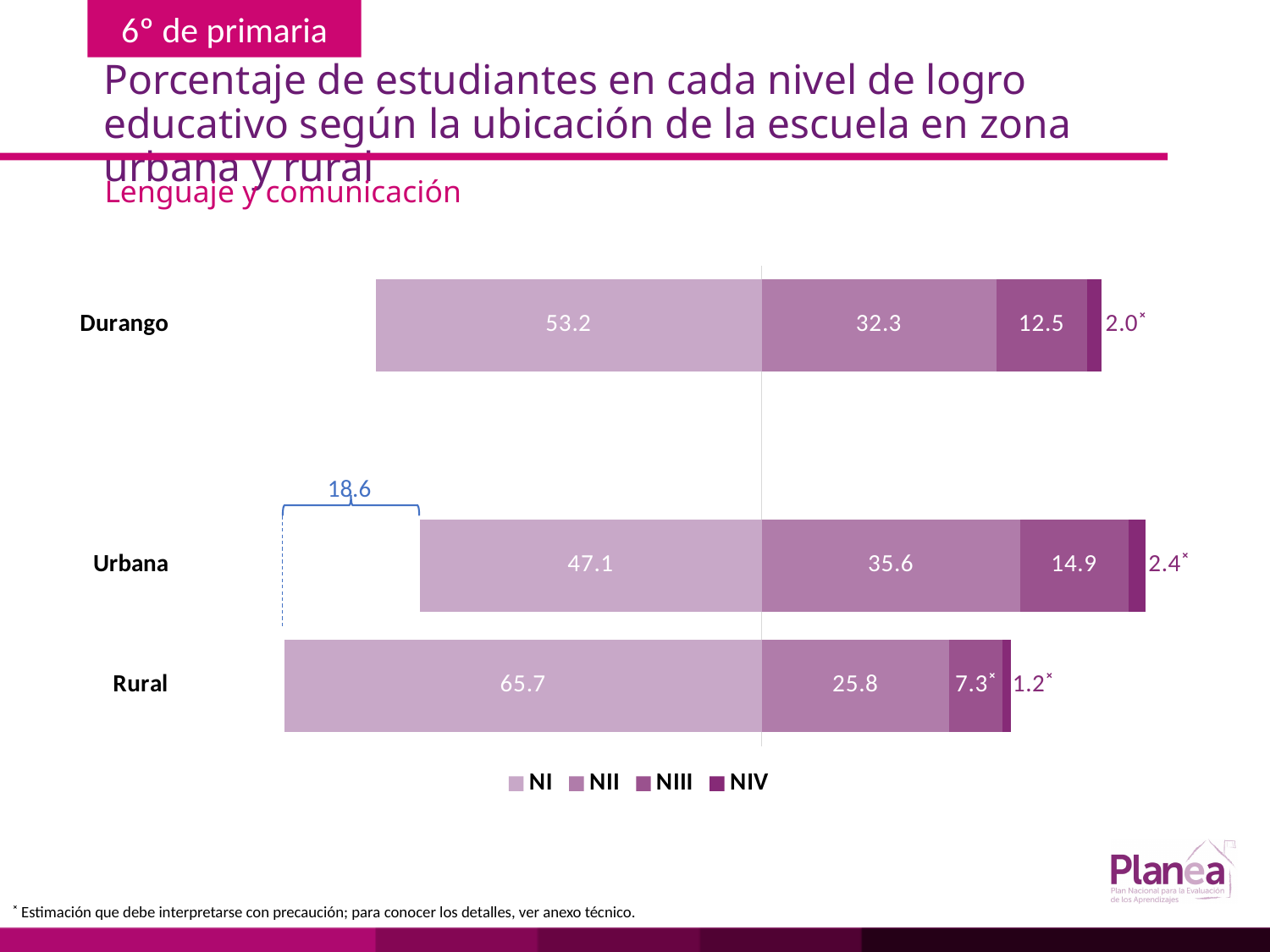
What is the difference between the NI value for Rural and the NI value for Urbana? 18.6 How many categories (bars) are plotted in the chart? 3 Which category has the highest NI value? Rural What is the subtitle of the chart shown below the main title? Lenguaje y comunicación How many series does the legend list? 4 Which is larger, the NII value for Durango or the NII value for Rural? Durango What is the NIII value for Durango? 12.5 What kind of chart is shown on the slide? Stacked bar chart What is the NI value for Rural? 65.7 What is the NII value for Urbana? 35.6 What is the NIV value for Rural? 1.2 Which category has the lowest NIII value? Rural